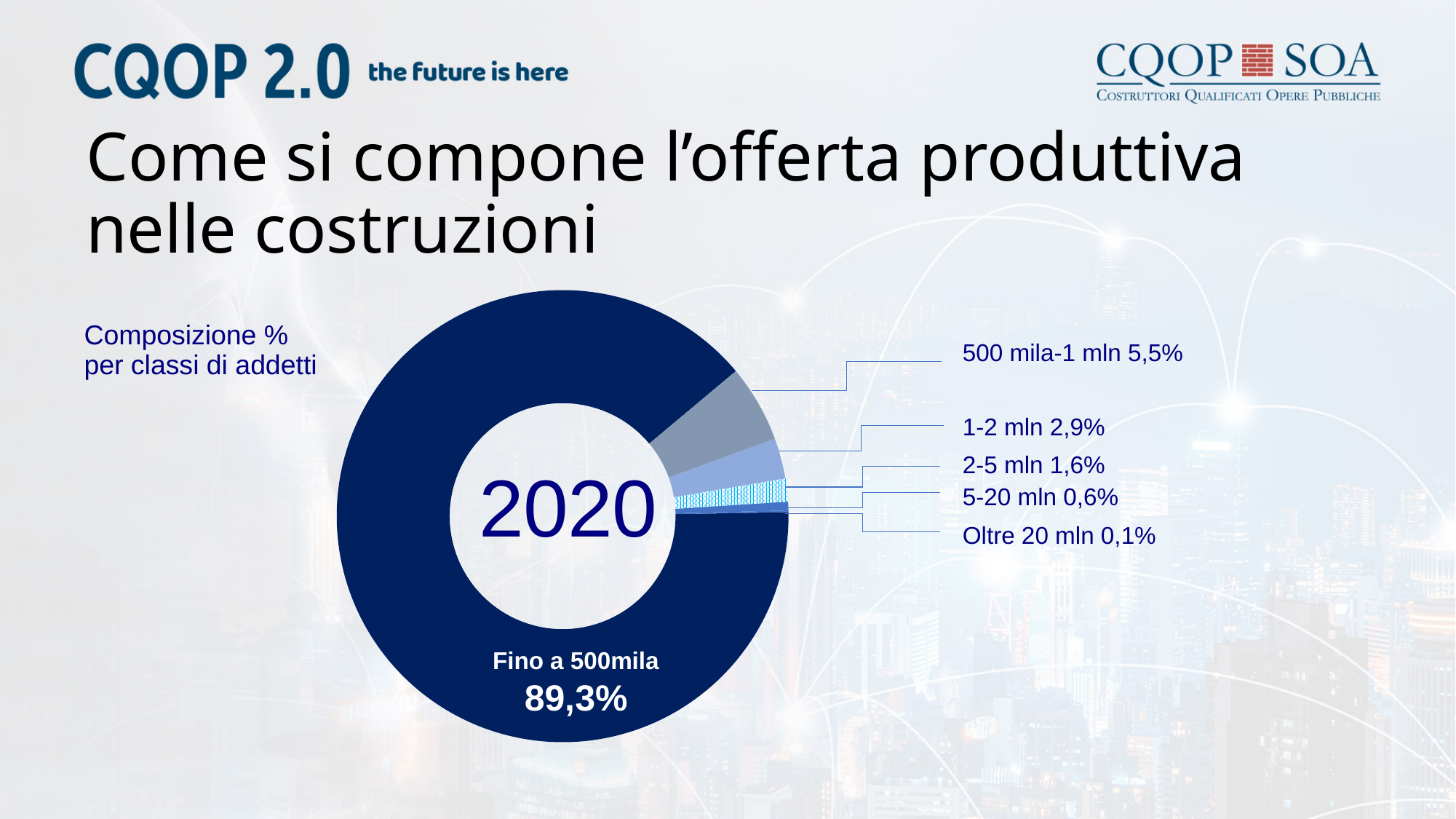
Which is larger, the share for '2-5 mln' or the share for '5-20 mln'? 2-5 mln What is the value shown for the '500 mila-1 mln' category? 5,5% What is the difference in percentage points between the '500 mila-1 mln' and '1-2 mln' categories? 2,6 What is the value shown for the '1-2 mln' category? 2,9% What is the value shown for the '2-5 mln' category? 1,6% How many categories are shown in the chart? 6 What share of the pie does the 'Fino a 500mila' slice represent? 89,3% What kind of chart is shown on the slide? Pie chart (doughnut) Which category has the largest share of the chart? Fino a 500mila Which category has the smallest share of the chart? Oltre 20 mln What is the value shown for the '5-20 mln' category? 0,6% What is the value shown for the 'Oltre 20 mln' category? 0,1%